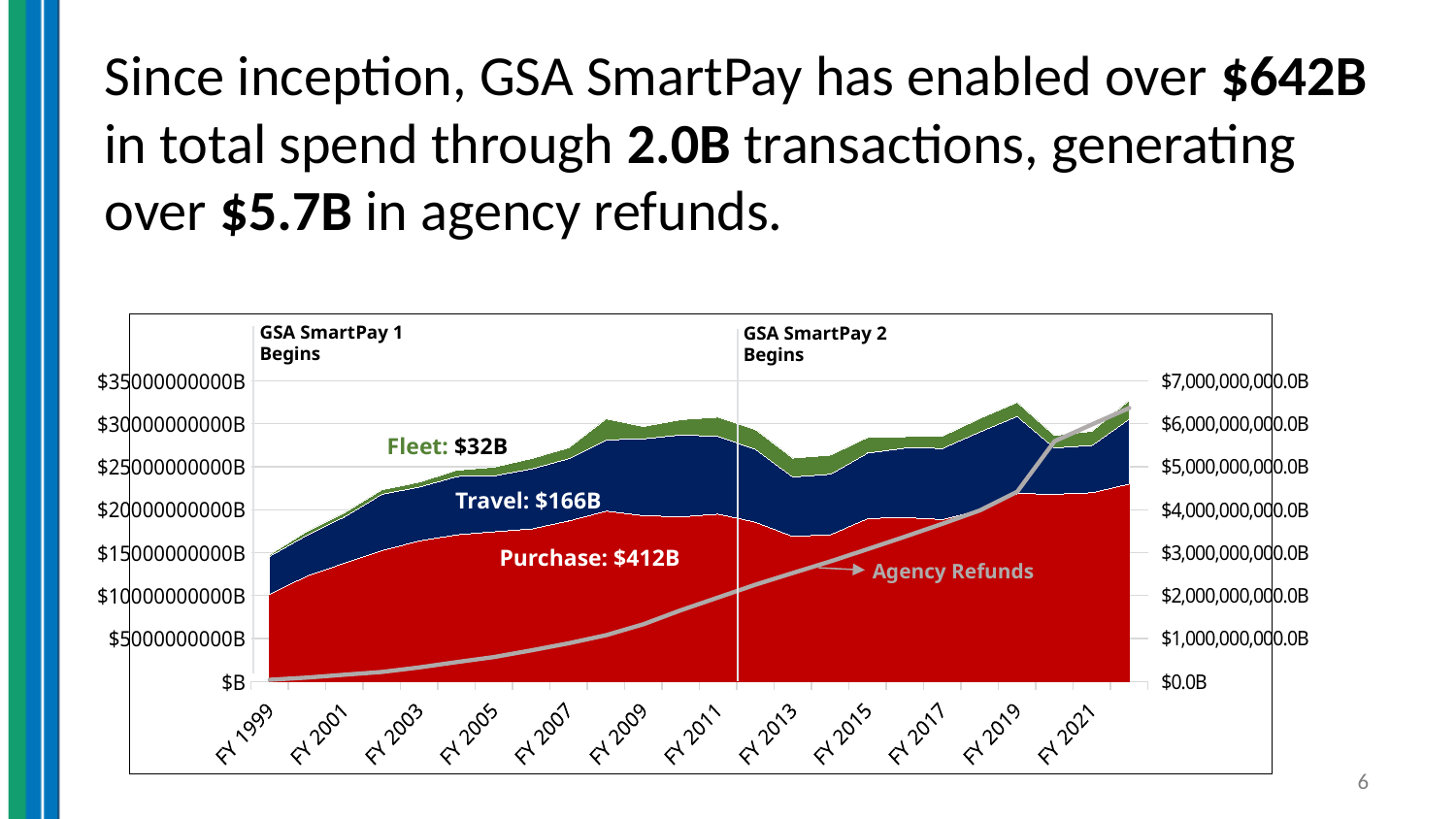
What value is labeled for Purchase on the chart? $412B Is the labeled Travel value larger or smaller than the labeled Purchase value? smaller Is the Agency Refunds value in FY 1999 greater or less than $1,000,000,000.0B on the right axis? less Which of the three labeled spend categories (Fleet, Travel, Purchase) has the largest value? Purchase What kind of chart is shown on the slide? combination area and line chart How many fiscal year labels are shown on the x axis? 12 What value is labeled for Fleet on the chart? $32B Which of the three labeled spend categories (Fleet, Travel, Purchase) has the smallest value? Fleet What is the difference between the labeled Purchase value and the labeled Travel value? $246B Does the Agency Refunds line generally rise or fall from FY 1999 to FY 2021? rise What value is labeled for Travel on the chart? $166B What event is annotated at the vertical line near FY 2012 on the chart? GSA SmartPay 2 Begins